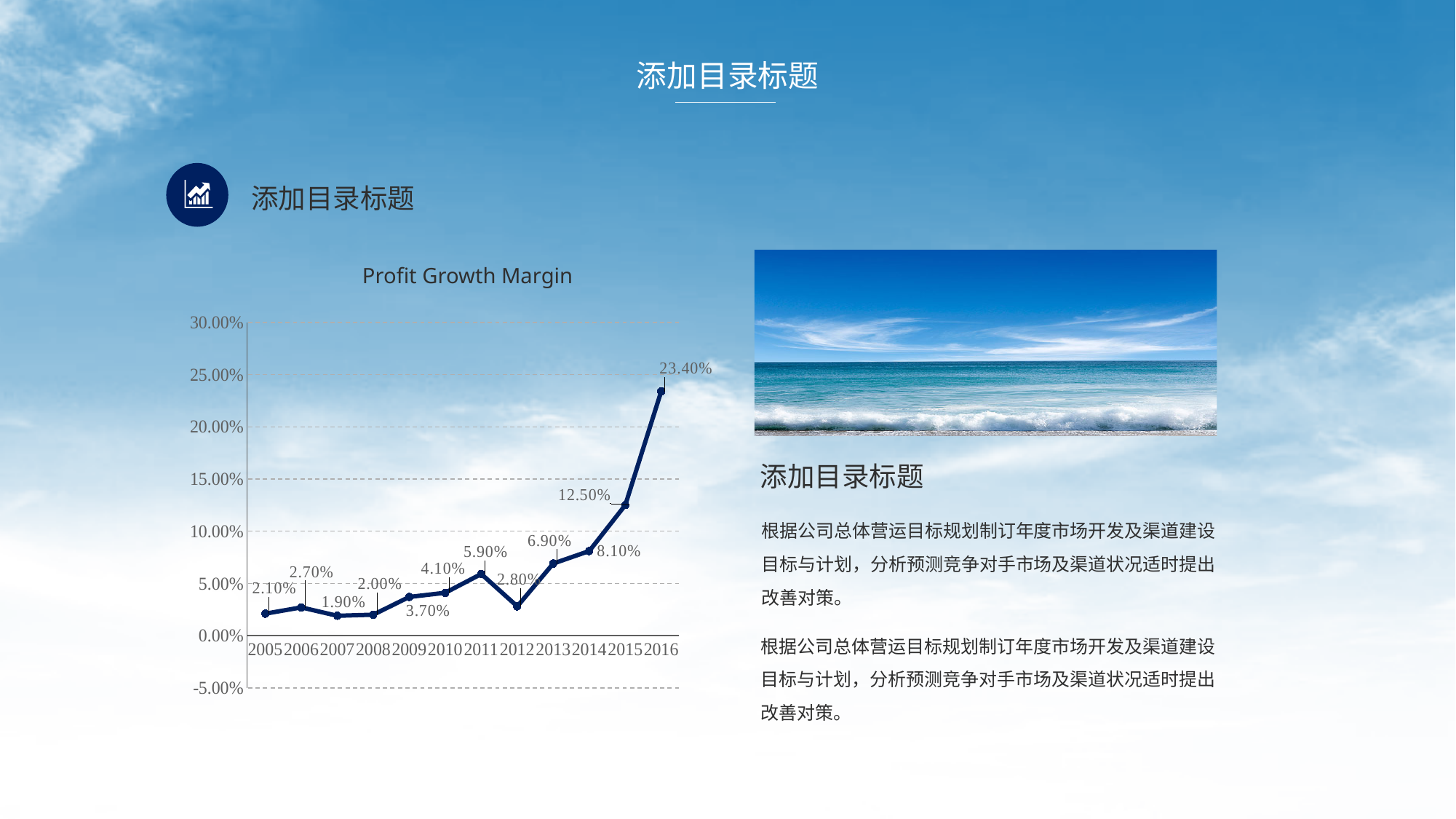
Which is larger in the Profit Growth Margin chart, the value for 2011 or the value for 2012? 2011 How many years are plotted in the Profit Growth Margin chart? 12 What is the value for 2012 in the Profit Growth Margin chart? 2.80% Do the values in the Profit Growth Margin chart rise or fall from 2013 to 2016? Rise What is the title of the chart on the slide? Profit Growth Margin What is the value for 2009 in the Profit Growth Margin chart? 3.70% What kind of chart is the Profit Growth Margin chart? Line chart Is the value for 2015 in the Profit Growth Margin chart greater or less than 10.00%? greater Which year has the lowest value in the Profit Growth Margin chart? 2007 Which year has the highest value in the Profit Growth Margin chart? 2016 What is the difference between the values for 2016 and 2015 in the Profit Growth Margin chart? 10.90% What is the value for 2016 in the Profit Growth Margin chart? 23.40%